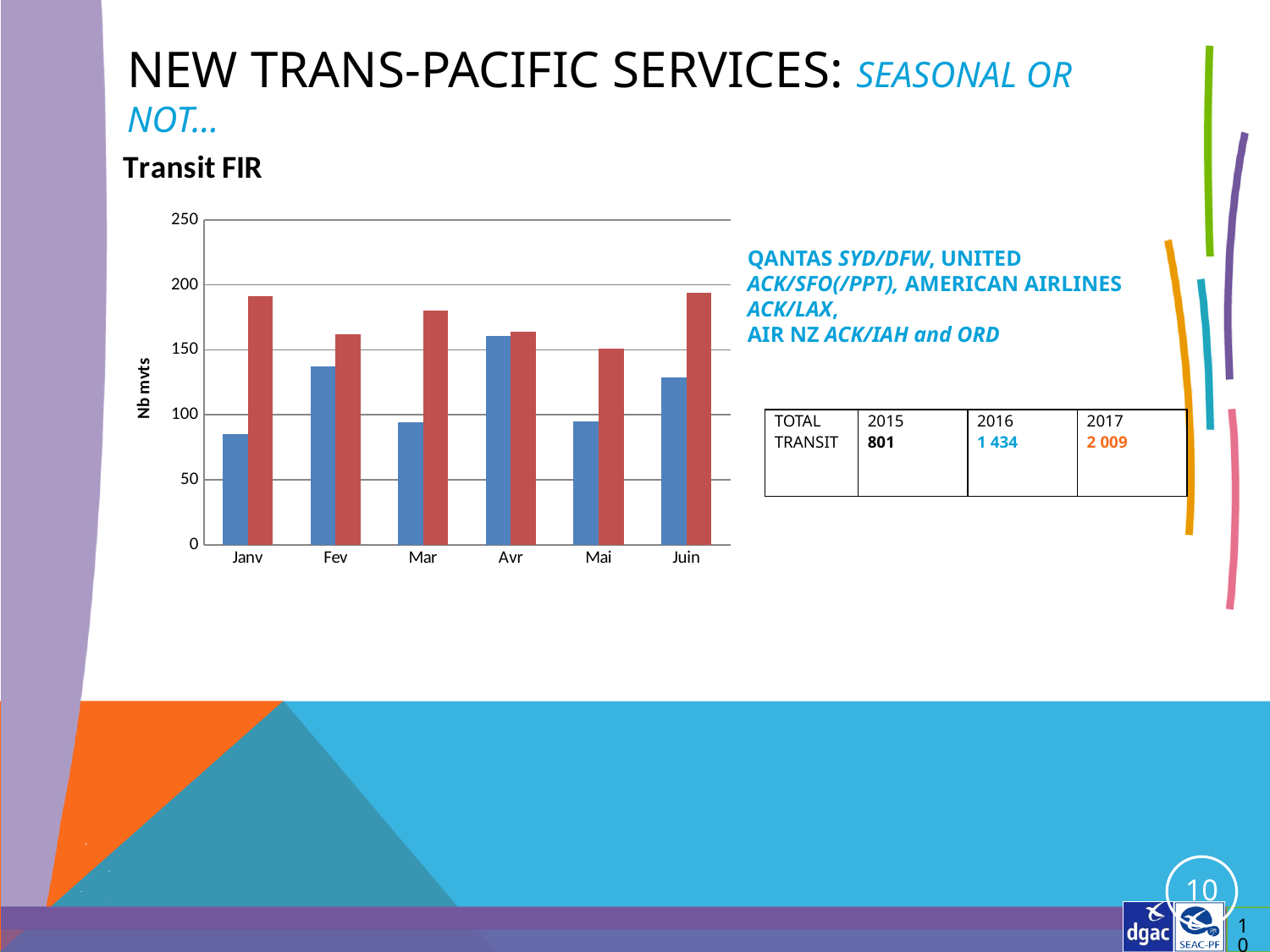
What is the label of the vertical axis of the chart? Nb mvts In which month is the blue bar the highest? Avr For Janv, which bar is larger, the blue one or the red one? the red one Is the value of the blue bar for Janv greater or less than 100? less What is the title shown above the chart? Transit FIR How many months are shown on the x axis of the chart? 6 Is the value of the red bar for Mar greater or less than 150? greater What kind of chart is shown under the heading 'Transit FIR'? bar chart Is the value of the red bar for Janv greater or less than 150? greater How many bars are plotted for each month in the chart? 2